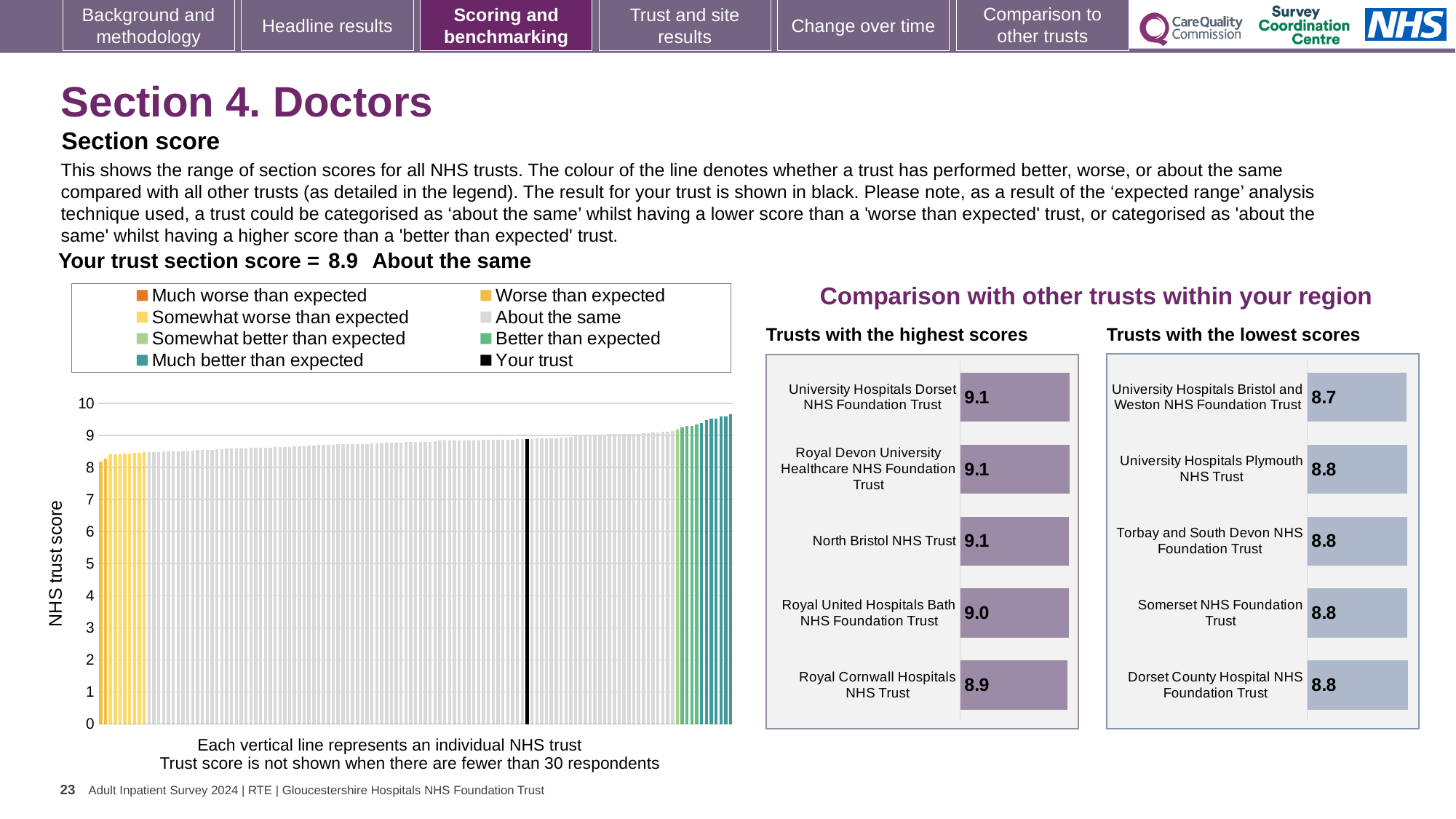
What kind of chart is the large chart on the left showing NHS trust scores? Bar chart On the 'Trusts with the highest scores' chart, which trust has the lowest score? Royal Cornwall Hospitals NHS Trust On the 'Trusts with the lowest scores' chart, which trust has the lowest score? University Hospitals Bristol and Weston NHS Foundation Trust On the large chart on the left, do the trust scores rise or fall from left to right? Rise How many entries does the legend of the large chart on the left list? 8 On the 'Trusts with the highest scores' chart, what is the score for University Hospitals Dorset NHS Foundation Trust? 9.1 On the 'Trusts with the highest scores' chart, what is the difference between the scores of University Hospitals Dorset NHS Foundation Trust and Royal Cornwall Hospitals NHS Trust? 0.2 On the 'Trusts with the highest scores' chart, which has the larger score: Royal United Hospitals Bath NHS Foundation Trust or Royal Cornwall Hospitals NHS Trust? Royal United Hospitals Bath NHS Foundation Trust On the 'Trusts with the highest scores' chart, what is the score for Royal United Hospitals Bath NHS Foundation Trust? 9.0 On the 'Trusts with the lowest scores' chart, what is the score for Somerset NHS Foundation Trust? 8.8 On the 'Trusts with the highest scores' chart, how many trusts are shown? 5 On the 'Trusts with the lowest scores' chart, what is the difference between the scores of University Hospitals Plymouth NHS Trust and University Hospitals Bristol and Weston NHS Foundation Trust? 0.1